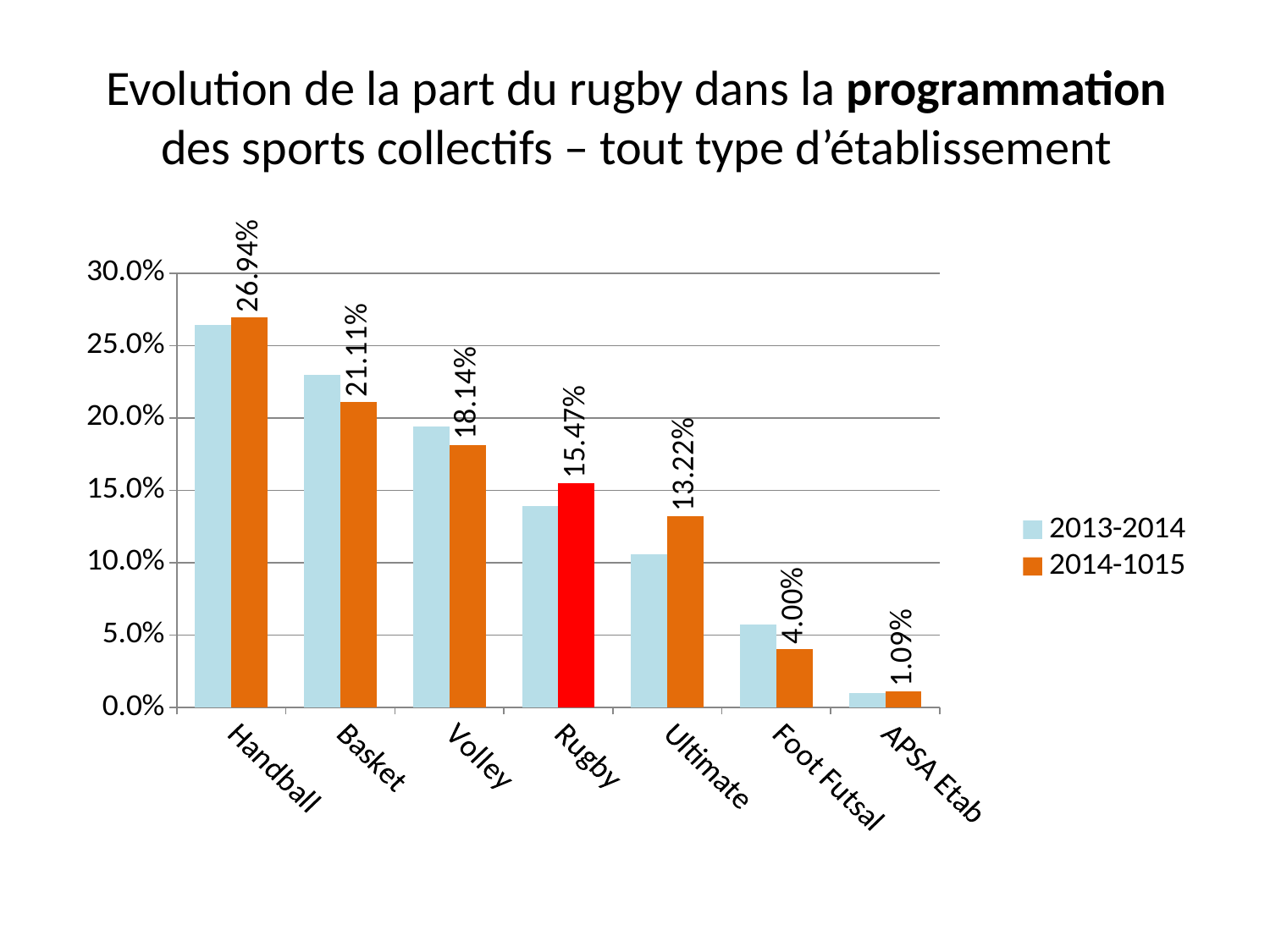
Is the 2013-2014 value for Basket greater or less than 20.0%? greater Is the 2013-2014 value for Ultimate greater or less than 15.0%? less What is the 2014-1015 value for Foot Futsal? 4.00% What is the difference between the 2014-1015 values for Basket and Volley? 2.97% What is the 2014-1015 value for Rugby? 15.47% How many categories are shown on the x axis? 7 Which category has the highest 2014-1015 value? Handball Which category has the lowest 2014-1015 value? APSA Etab For Rugby, which series has the larger value, 2013-2014 or 2014-1015? 2014-1015 How many series does the legend list? 2 What kind of chart is shown on the slide? Bar chart What is the 2014-1015 value for Handball? 26.94%